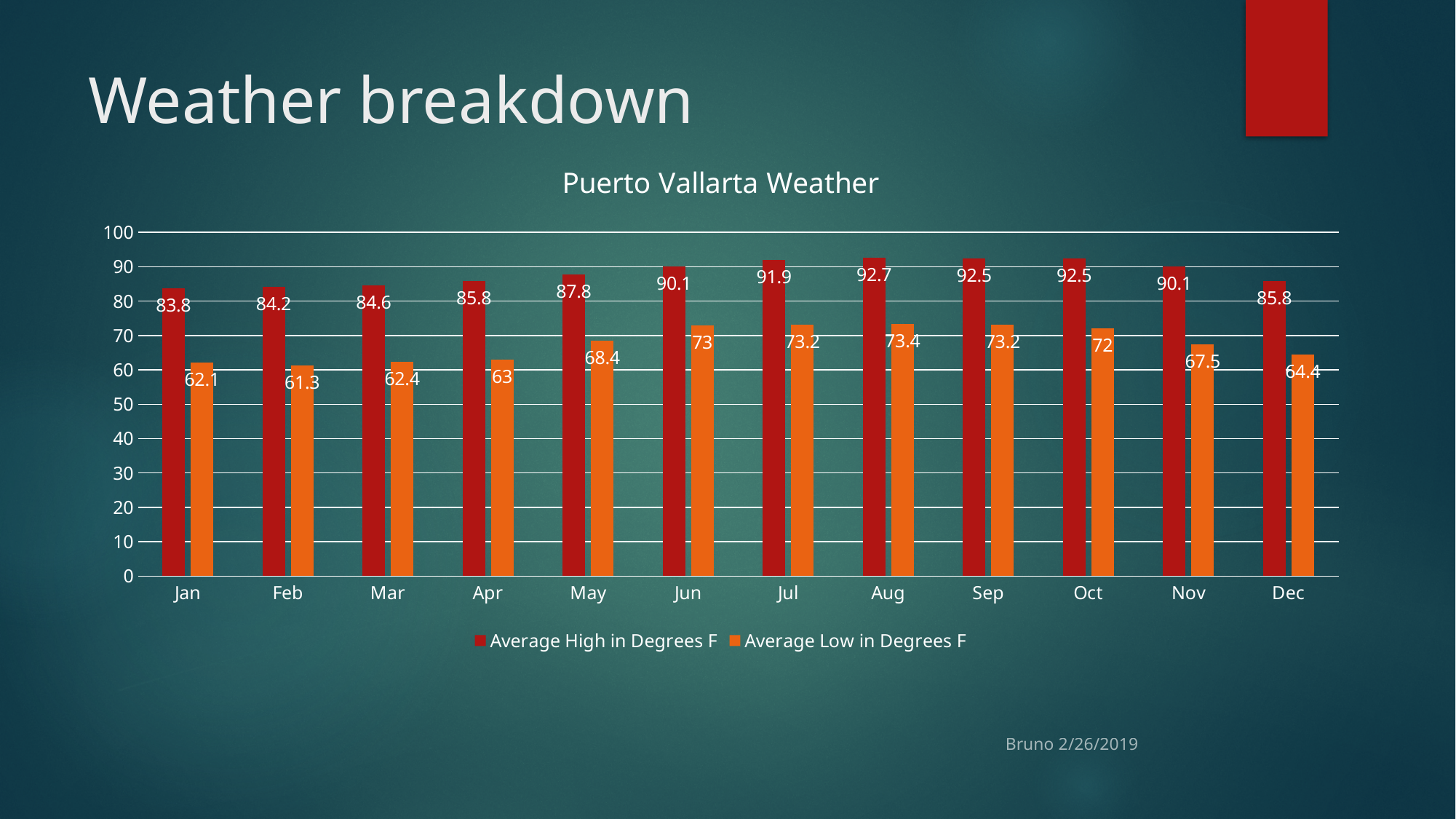
What is the Average High in Degrees F for Aug? 92.7 Is the Average High in Degrees F for Jun greater or less than 80? greater What is the title of the chart? Puerto Vallarta Weather How many series does the legend list? 2 Which is larger, the Average Low in Degrees F for May or for Nov? May How many months are shown on the x axis? 12 What is the difference between the Average High and Average Low in Degrees F for Jan? 21.7 Which month has the highest Average High in Degrees F? Aug What is the Average Low in Degrees F for Feb? 61.3 Does the Average High in Degrees F rise or fall from Jan to Aug? rise Which month has the lowest Average Low in Degrees F? Feb What kind of chart is shown on the slide? bar chart